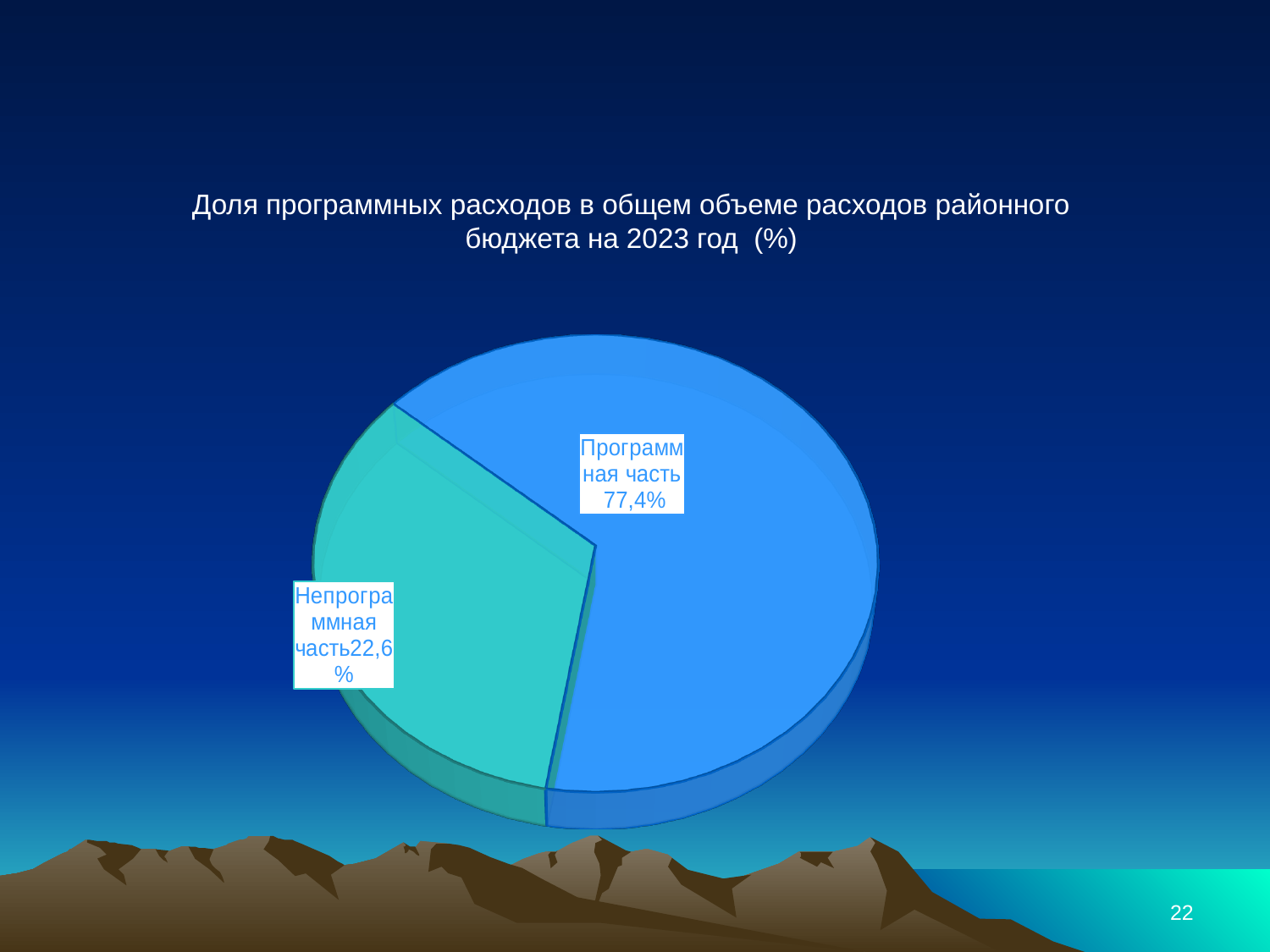
How many slices does the pie chart have? 2 What colour is the "Непрограммная часть" slice? Turquoise (teal) What kind of chart is shown on the slide? Pie chart What is the total of the two slices' shares? 100% Is the share of "Программная часть" greater or less than 50%? greater What is the title of the chart? Доля программных расходов в общем объеме расходов районного бюджета на 2023 год (%) What share of the pie does "Программная часть" have? 77,4% Which is larger, "Программная часть" or "Непрограммная часть"? Программная часть What share of the pie does "Непрограммная часть" have? 22,6% Which slice is the smallest? Непрограммная часть What is the difference in percentage points between "Программная часть" and "Непрограммная часть"? 54,8 Which slice is the largest? Программная часть